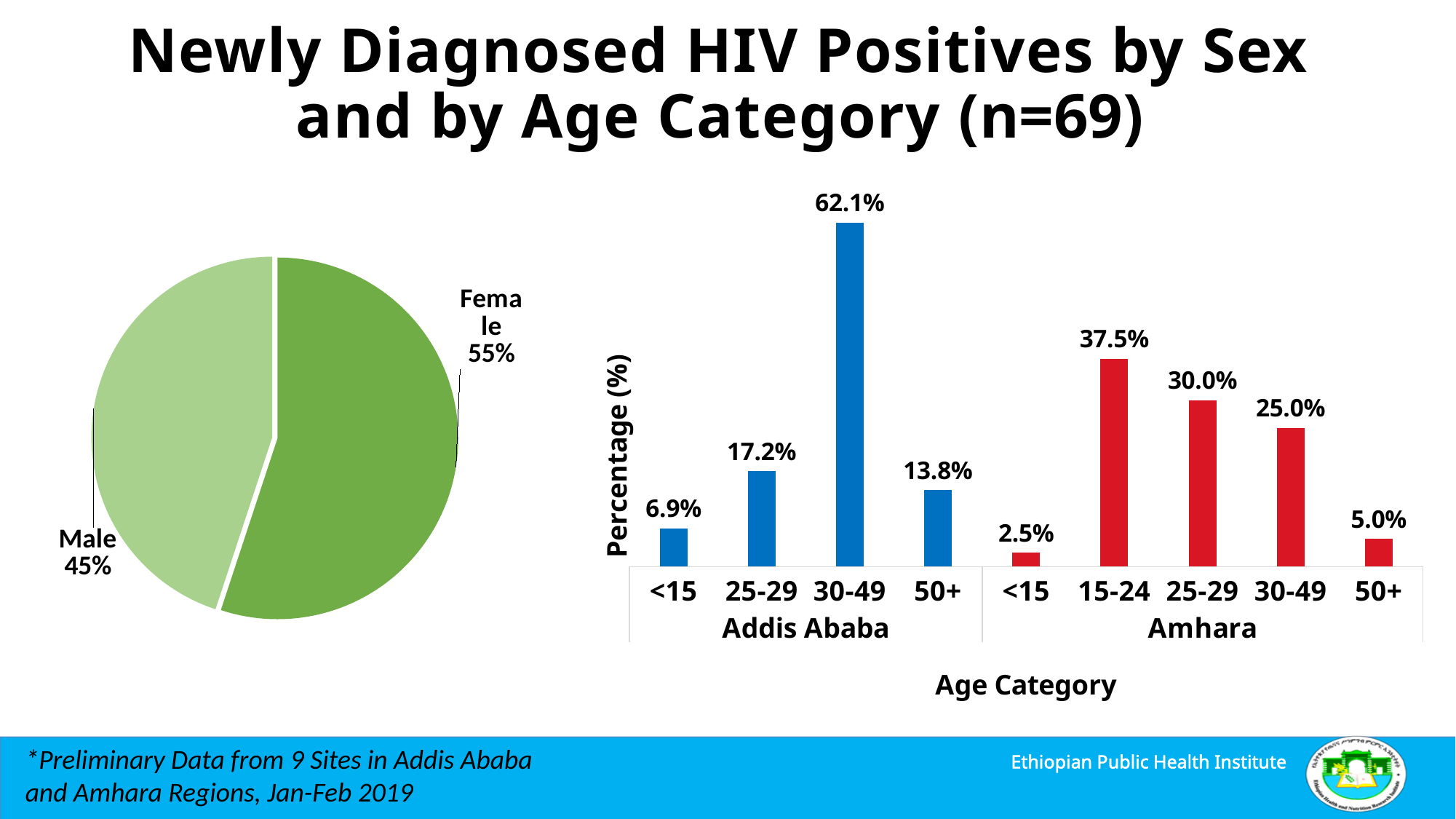
In the bar chart on the right, how many age category bars are shown for Amhara? 5 In the bar chart on the right, which is larger: the 50+ percentage in Addis Ababa or the 50+ percentage in Amhara? Addis Ababa In the bar chart on the right, what is the percentage for the 30-49 age category in Addis Ababa? 62.1% In the bar chart on the right, which age category has the lowest percentage in Amhara? <15 What kind of chart is the chart on the left of the slide? Pie chart In the bar chart on the right, what is the percentage for the 15-24 age category in Amhara? 37.5% In the bar chart on the right, which age category has the highest percentage in Addis Ababa? 30-49 In the pie chart on the left, what share of newly diagnosed HIV positives is Male? 45% What kind of chart is the chart on the right of the slide? Bar chart In the pie chart on the left, what share of newly diagnosed HIV positives is Female? 55% In the bar chart on the right, what is the difference between the 25-29 percentage in Amhara and the 25-29 percentage in Addis Ababa? 12.8% In the bar chart on the right, what is the label of the y axis? Percentage (%)